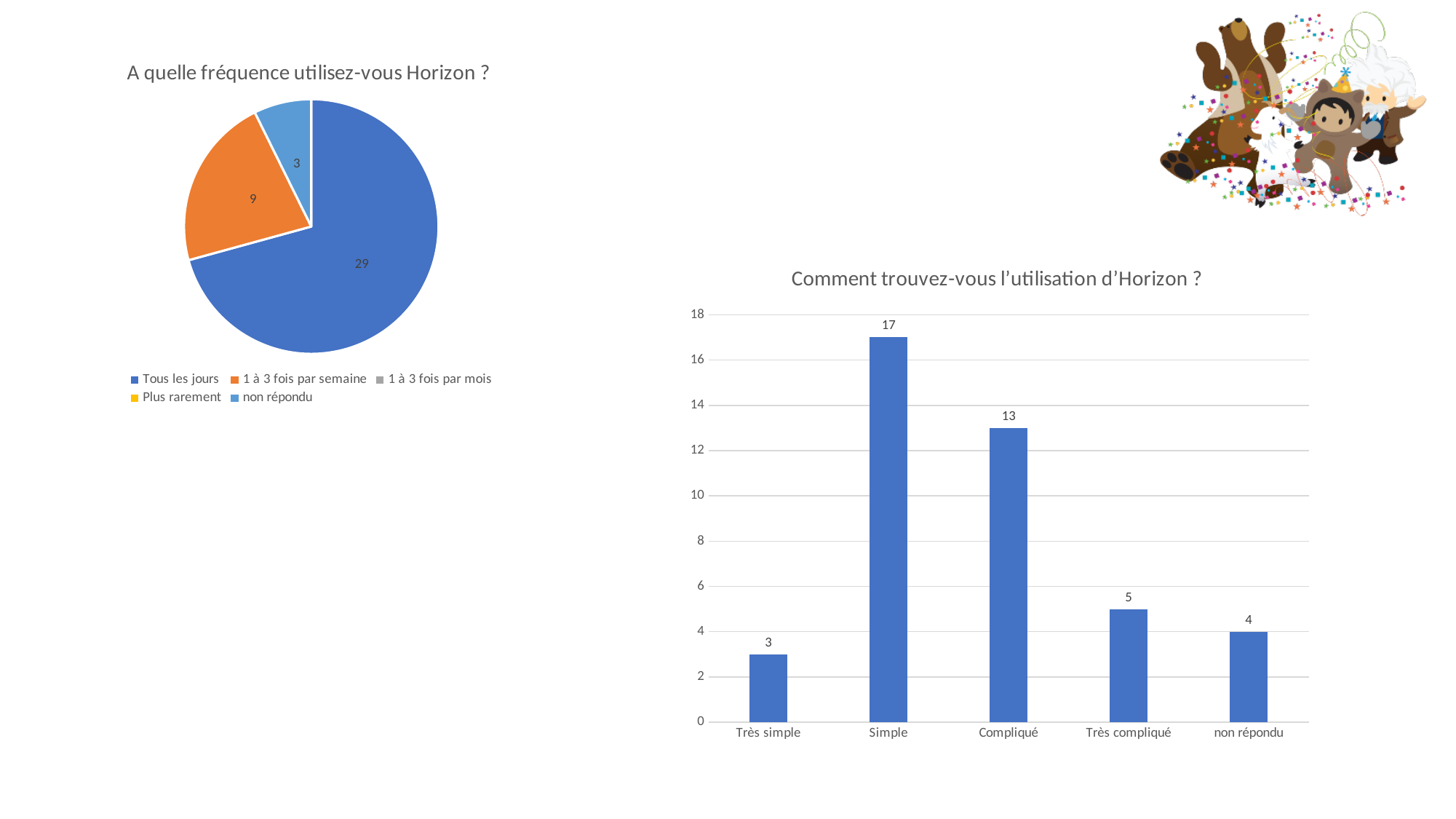
In the pie chart 'A quelle fréquence utilisez-vous Horizon ?', which category has the largest slice? Tous les jours In the pie chart 'A quelle fréquence utilisez-vous Horizon ?', how many entries does the legend list? 5 In the bar chart 'Comment trouvez-vous l'utilisation d'Horizon ?', which category has the lowest value? Très simple In the pie chart 'A quelle fréquence utilisez-vous Horizon ?', what is the value for 'Tous les jours'? 29 What kind of chart is 'Comment trouvez-vous l'utilisation d'Horizon ?'? Bar chart In the bar chart 'Comment trouvez-vous l'utilisation d'Horizon ?', how many categories are shown on the x axis? 5 In the bar chart 'Comment trouvez-vous l'utilisation d'Horizon ?', what is the difference between 'Simple' and 'Compliqué'? 4 In the pie chart 'A quelle fréquence utilisez-vous Horizon ?', what is the difference between 'Tous les jours' and '1 à 3 fois par semaine'? 20 In the pie chart 'A quelle fréquence utilisez-vous Horizon ?', what is the value for '1 à 3 fois par semaine'? 9 In the bar chart 'Comment trouvez-vous l'utilisation d'Horizon ?', what is the value for 'Compliqué'? 13 In the bar chart 'Comment trouvez-vous l'utilisation d'Horizon ?', which is larger, 'Très compliqué' or 'non répondu'? Très compliqué In the bar chart 'Comment trouvez-vous l'utilisation d'Horizon ?', what is the value for 'Simple'? 17